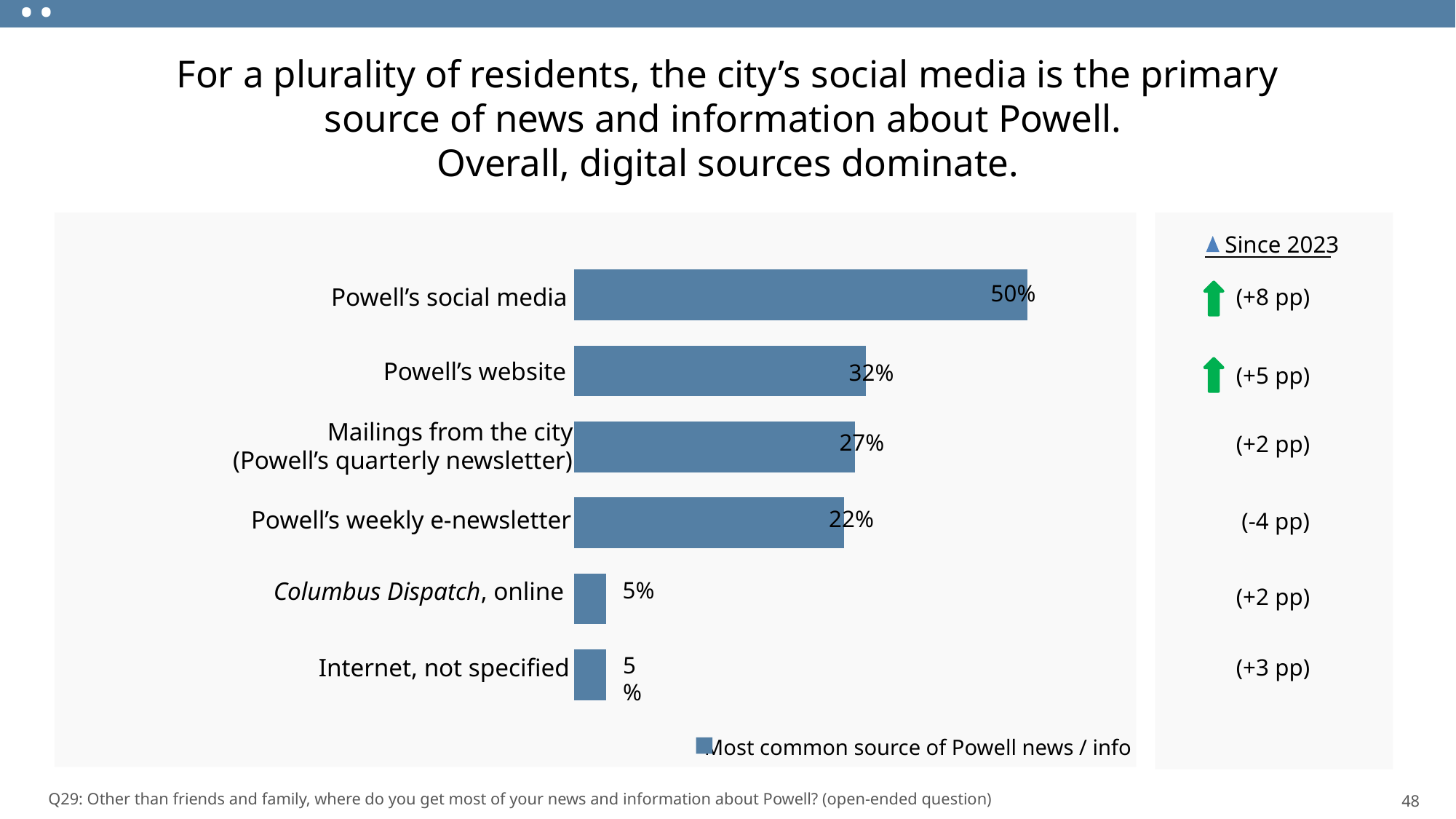
What percentage of residents cite Powell's social media as their most common source of Powell news? 50% How many series does the legend list? 1 How many sources (categories) are shown in the bar chart? 6 What is the value for Powell's weekly e-newsletter? 22% Which source has the highest percentage in the chart? Powell's social media According to the 'Since 2023' column, what is the change for Powell's weekly e-newsletter? (-4 pp) What percentage is shown for Mailings from the city (Powell's quarterly newsletter)? 27% What is the difference between the values for Powell's website and Powell's weekly e-newsletter? 10 What is the value shown for Powell's website? 32% What kind of chart is shown on the slide? Bar chart What is the difference in percentage points between Powell's social media and Powell's website? 18 Which is larger: the value for Mailings from the city or the value for Powell's weekly e-newsletter? Mailings from the city